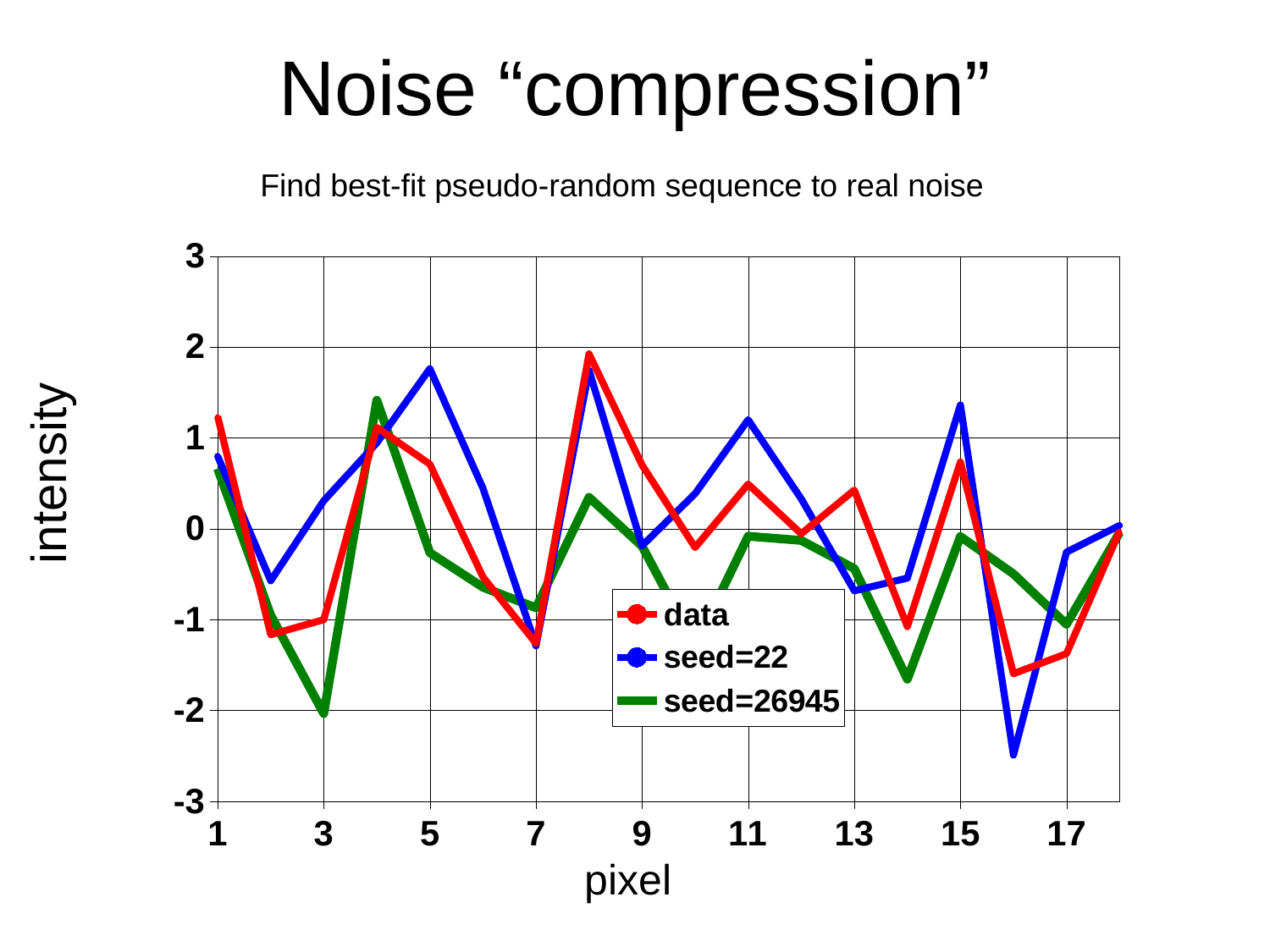
What kind of chart is shown on the slide? line chart Is the value of the data series at pixel 14 greater or less than 0? less At pixel 5, which series has the highest value? seed=22 How many series does the legend list? 3 Is the value of the data series at pixel 8 greater or less than 1? greater At pixel 3, which is larger: the data series or the seed=26945 series? data Is the value of the seed=26945 series at pixel 4 greater or less than 1? greater At which pixel does the seed=22 series reach its lowest value? 16 At pixel 16, which series has the lowest value? seed=22 What are the x-axis and y-axis labels of the chart? pixel and intensity What are the three series named in the legend? data, seed=22, seed=26945